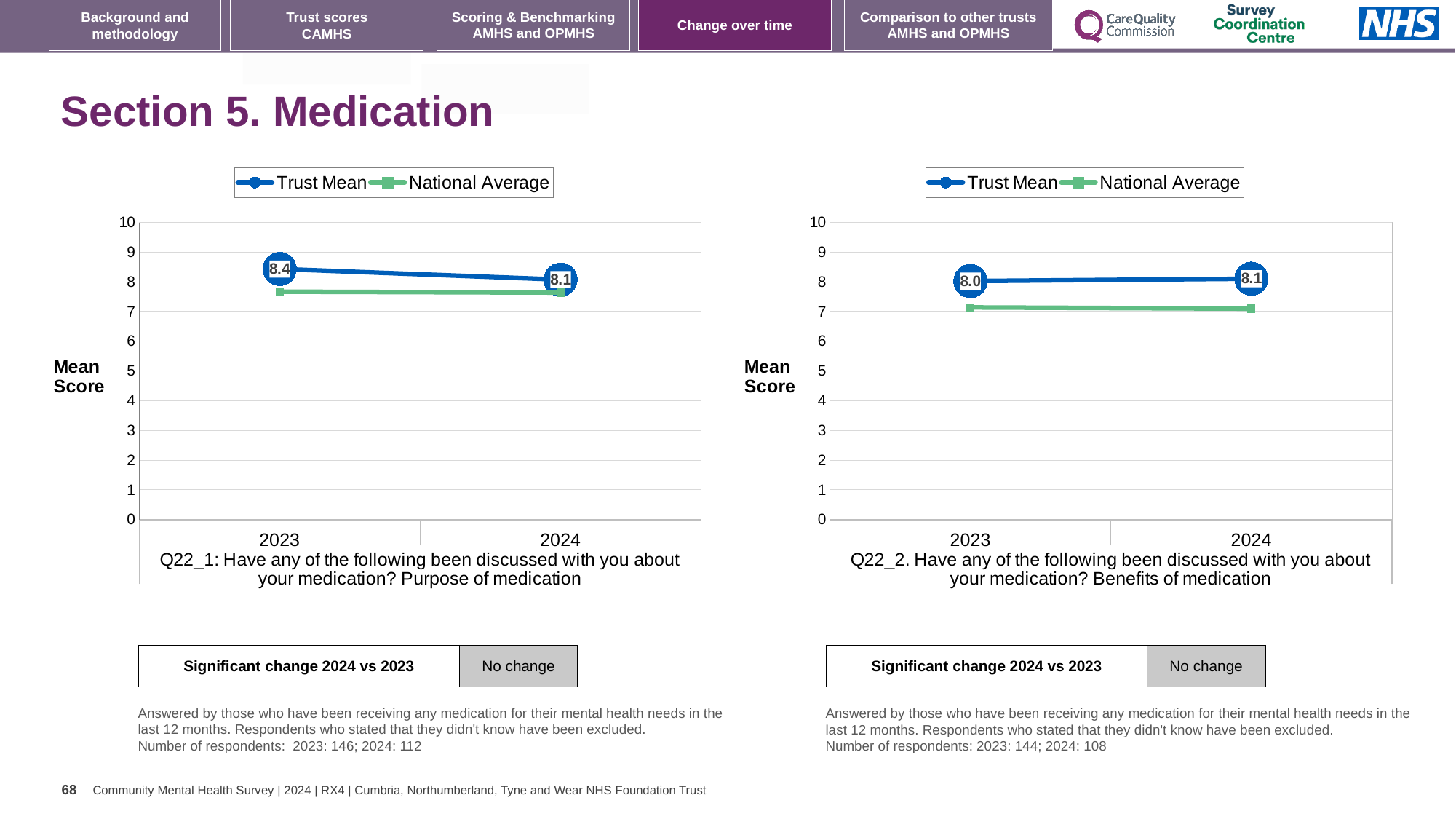
In the right chart (Q22_2: Benefits of medication), does the Trust Mean rise or fall from 2023 to 2024? rise In the left chart (Q22_1: Purpose of medication), which series is higher in 2023, Trust Mean or National Average? Trust Mean How many years are plotted on the x axis of the right chart (Q22_2: Benefits of medication)? 2 In the right chart (Q22_2: Benefits of medication), is the National Average for 2024 greater or less than 8? less In the left chart (Q22_1: Purpose of medication), by how much did the Trust Mean change from 2023 to 2024? 0.3 What kind of chart is the left chart (Q22_1: Purpose of medication)? line chart In the left chart (Q22_1: Purpose of medication), what is the Trust Mean score for 2024? 8.1 In the left chart (Q22_1: Purpose of medication), does the Trust Mean rise or fall from 2023 to 2024? fall In the right chart (Q22_2: Benefits of medication), what is the Trust Mean score for 2023? 8.0 In the right chart (Q22_2: Benefits of medication), what is the Trust Mean score for 2024? 8.1 In the left chart (Q22_1: Purpose of medication), what is the Trust Mean score for 2023? 8.4 How many series does the legend of the right chart (Q22_2: Benefits of medication) list? 2